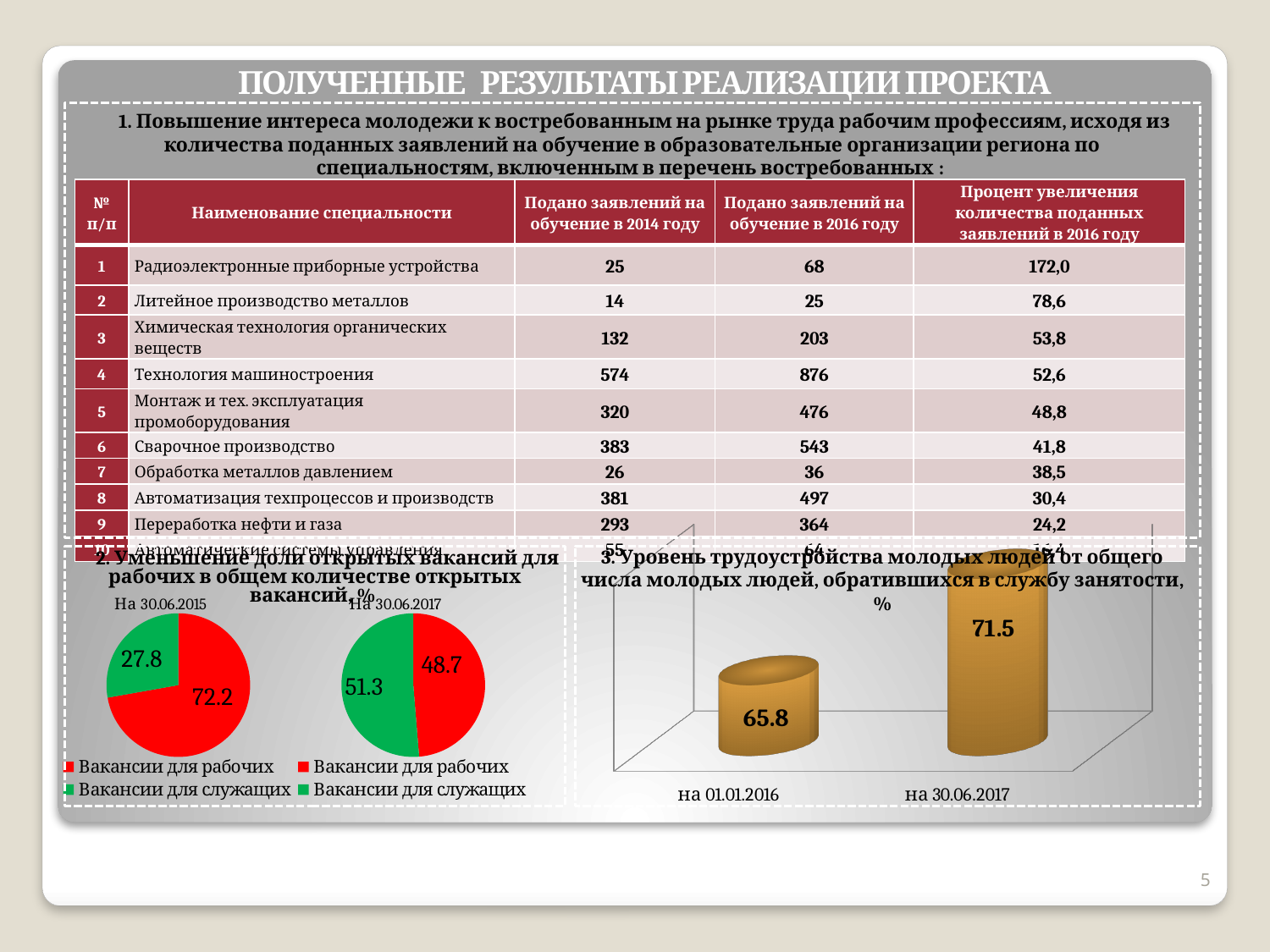
In the pie chart labelled 'На 30.06.2015', what is the value for 'Вакансии для рабочих'? 72.2 In the pie chart labelled 'На 30.06.2015', what is the difference between the 'Вакансии для рабочих' and 'Вакансии для служащих' values? 44.4 In the pie chart labelled 'На 30.06.2015', what is the value for 'Вакансии для служащих'? 27.8 In the pie chart labelled 'На 30.06.2017', which category has the smallest slice? Вакансии для рабочих In the chart titled '3. Уровень трудоустройства молодых людей...', what is the value for 'на 01.01.2016'? 65.8 In the pie chart labelled 'На 30.06.2015', which category has the largest slice? Вакансии для рабочих In the pie chart labelled 'На 30.06.2017', what is the value for 'Вакансии для служащих'? 51.3 How many slices does the pie chart labelled 'На 30.06.2017' have? 2 In the chart titled '3. Уровень трудоустройства молодых людей...', what is the value for 'на 30.06.2017'? 71.5 What type of chart is the one titled '3. Уровень трудоустройства молодых людей...' on the bottom right of the slide? Bar chart In the chart titled '3. Уровень трудоустройства молодых людей...', by how much does the value for 'на 30.06.2017' exceed the value for 'на 01.01.2016'? 5.7 In the pie chart labelled 'На 30.06.2017', what is the value for 'Вакансии для рабочих'? 48.7